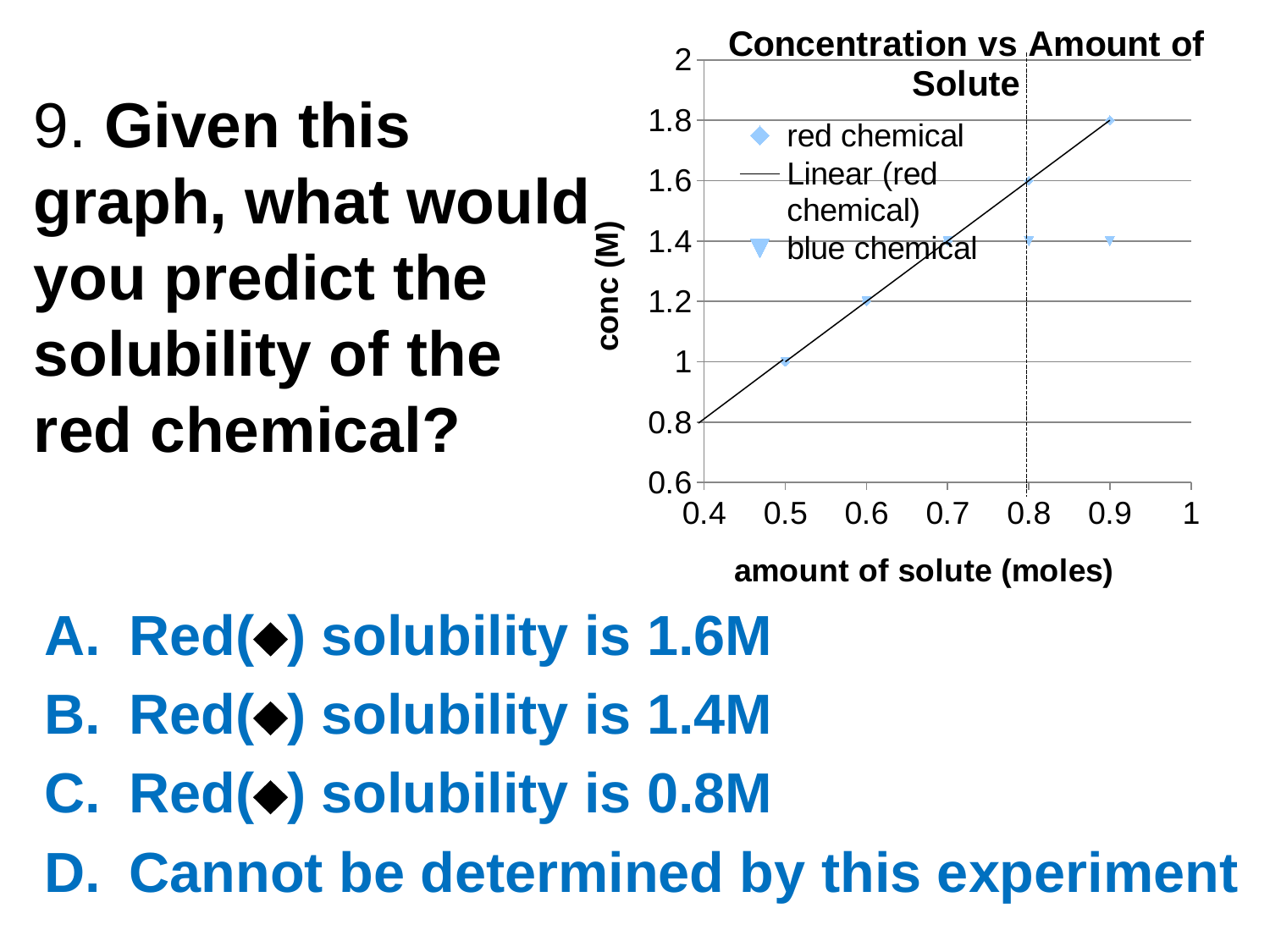
What is the concentration of the red chemical at 0.9 moles of solute? 1.8 Does the concentration of the red chemical rise or fall as the amount of solute increases? rise What is the difference between the red chemical's concentration at 0.9 moles and at 0.5 moles? 0.8 How many series does the chart legend list? 3 How many data points are plotted for the red chemical? 5 What is the concentration of the blue chemical at 0.9 moles of solute? 1.4 Is the concentration of the red chemical at 0.8 moles greater or less than 1.4? greater At 0.9 moles of solute, which chemical has the higher concentration, red or blue? red chemical What is the title of the chart? Concentration vs Amount of Solute What is the concentration of the red chemical at 0.5 moles of solute? 1 What kind of chart is shown on the slide? scatter chart What is the label of the x axis? amount of solute (moles)